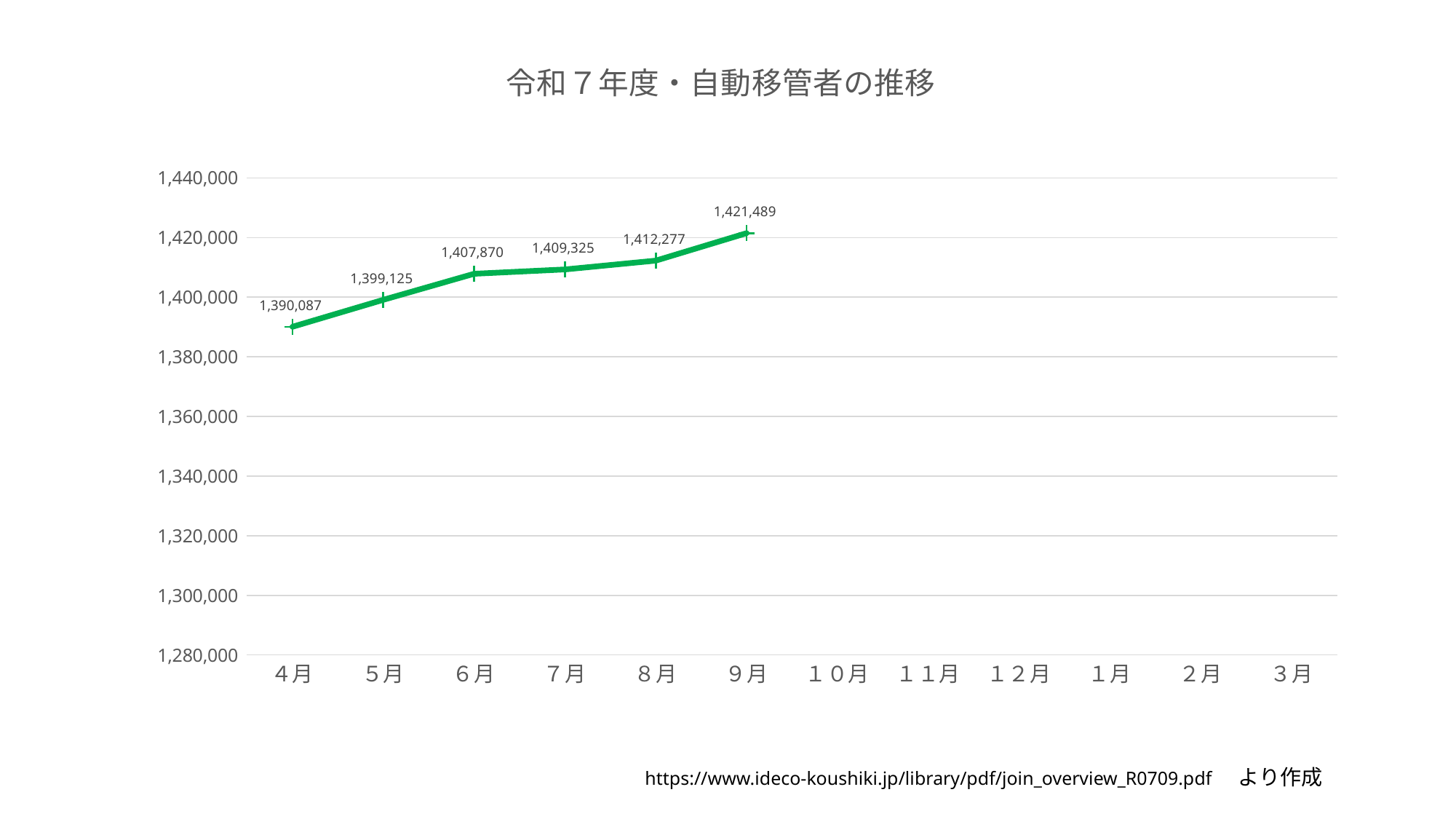
What kind of chart is shown? line chart What is the difference between the values for 9月 and 4月? 31,402 What is the value for 4月? 1,390,087 Which is larger, the value for 6月 or the value for 5月? 6月 Which month has the lowest plotted value? 4月 How many data points are plotted on the line? 6 Which month has the highest plotted value? 9月 What is the value for 7月? 1,409,325 Do the plotted values rise or fall from 4月 to 9月? rise Is the value for 8月 greater or less than 1,400,000? greater What is the value for 9月? 1,421,489 What is the difference between the values for 9月 and 8月? 9,212